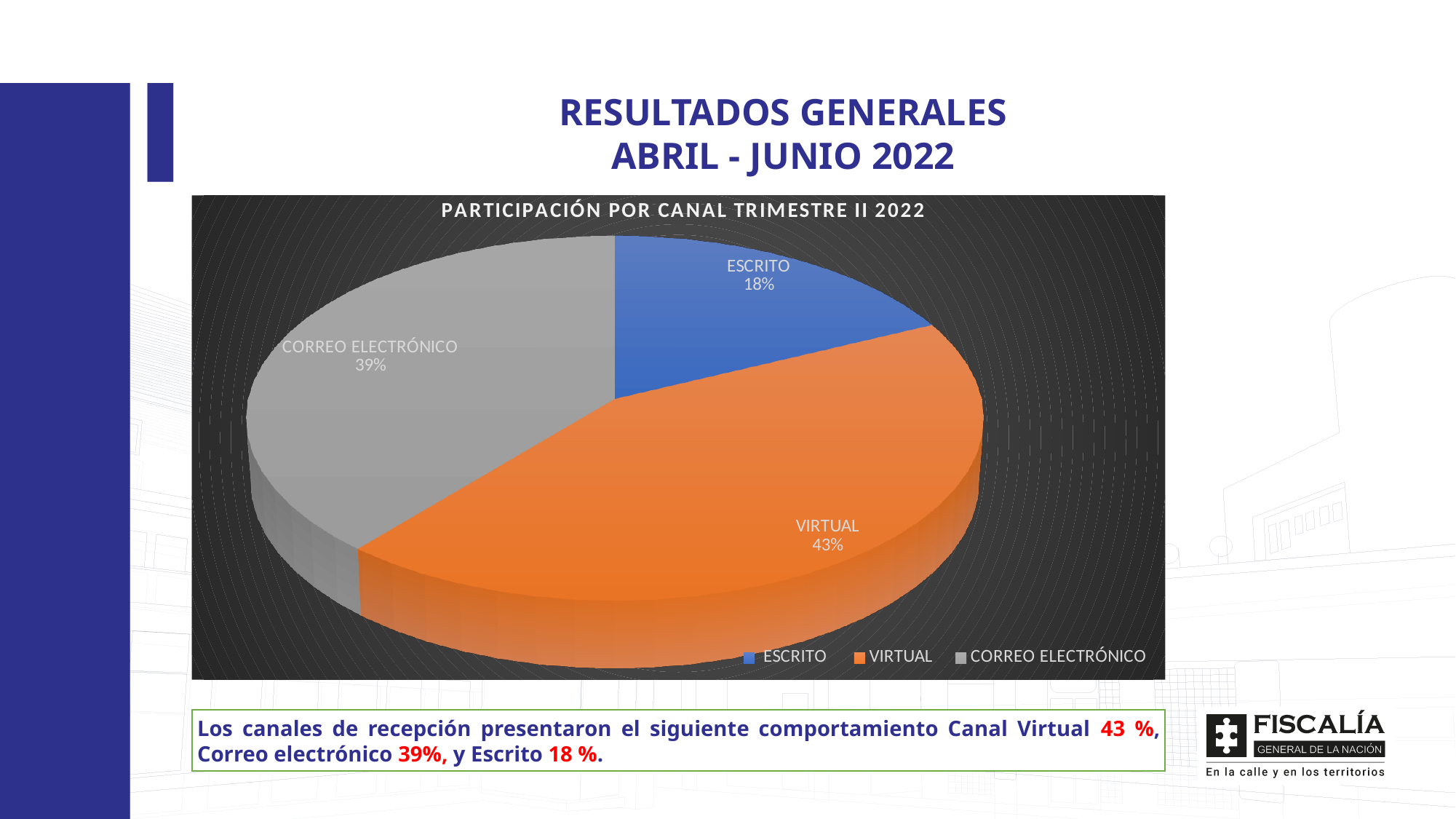
What share of the pie does VIRTUAL represent? 43% What share of the pie does CORREO ELECTRÓNICO represent? 39% What is the difference in percentage points between VIRTUAL and ESCRITO? 25 Which is larger, the share for CORREO ELECTRÓNICO or the share for ESCRITO? CORREO ELECTRÓNICO What kind of chart is shown on the slide? Pie chart What colour is the VIRTUAL slice in the pie chart? Orange What is the title of the chart? PARTICIPACIÓN POR CANAL TRIMESTRE II 2022 Which channel has the largest share of the pie? VIRTUAL What is the difference in percentage points between CORREO ELECTRÓNICO and ESCRITO? 21 How many slices does the pie chart have? 3 What is the value shown for ESCRITO? 18% Which channel has the smallest share of the pie? ESCRITO